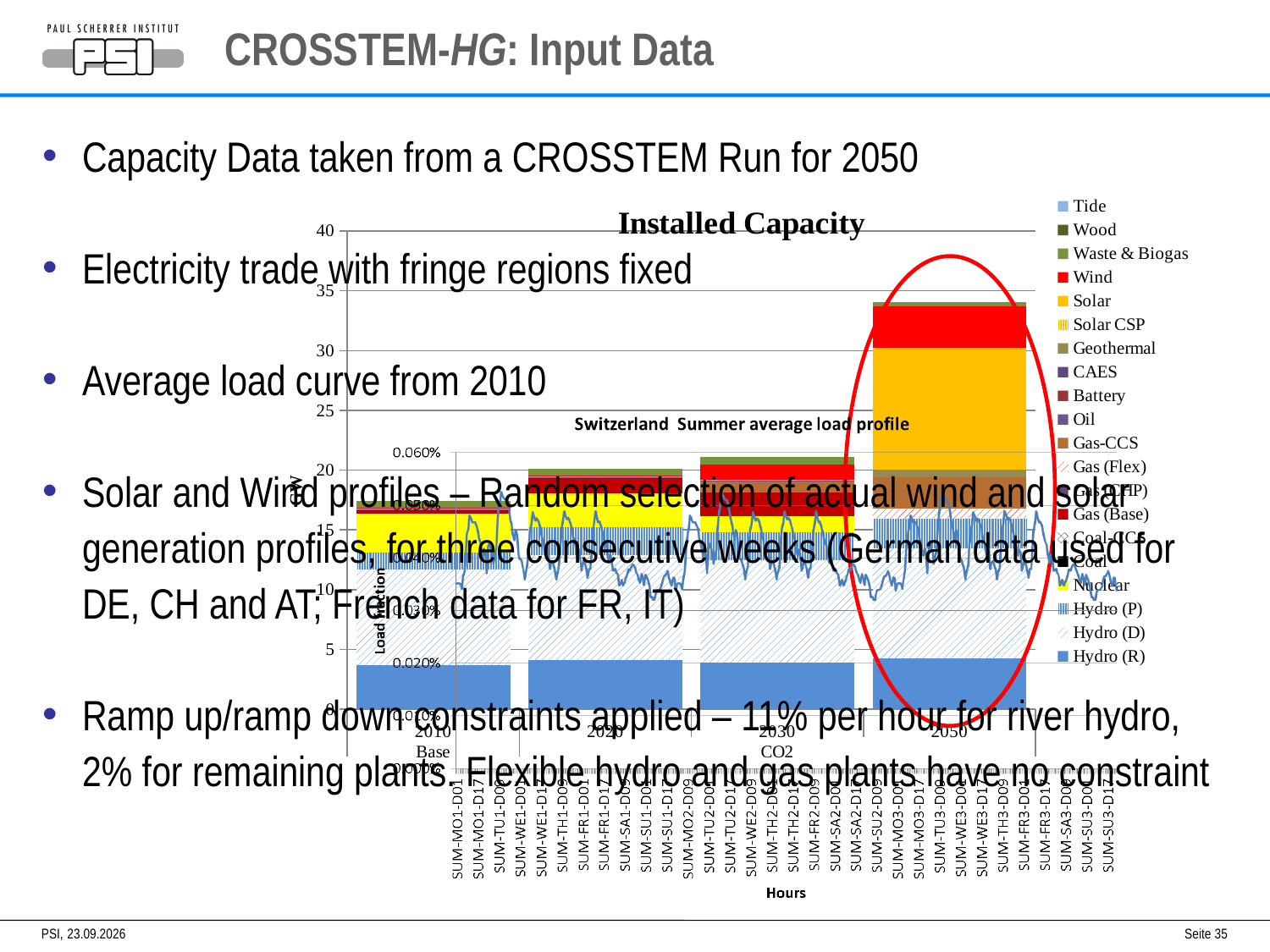
In the Installed Capacity chart, does total installed capacity rise or fall from 2010 Base to 2050? rise How many year categories are shown on the x axis of the Installed Capacity chart? 4 What type of chart is the Installed Capacity chart? Stacked bar chart In the Installed Capacity chart, which year has the lowest total installed capacity? 2010 Base How many series does the legend of the Installed Capacity chart list? 20 In the Installed Capacity chart, which is larger: the total capacity for 2030 CO2 or for 2050? 2050 In the Installed Capacity chart, which year has the highest total installed capacity? 2050 What unit is shown on the y axis of the Installed Capacity chart? GW In the Installed Capacity chart, is the total installed capacity for 2010 Base greater or less than 20? less In the Installed Capacity chart, is the total installed capacity for 2050 greater or less than 30? greater In the Installed Capacity chart, which series forms the largest segment of the 2050 bar? Solar What is the title of the line chart overlaid on the slide? Switzerland Summer average load profile